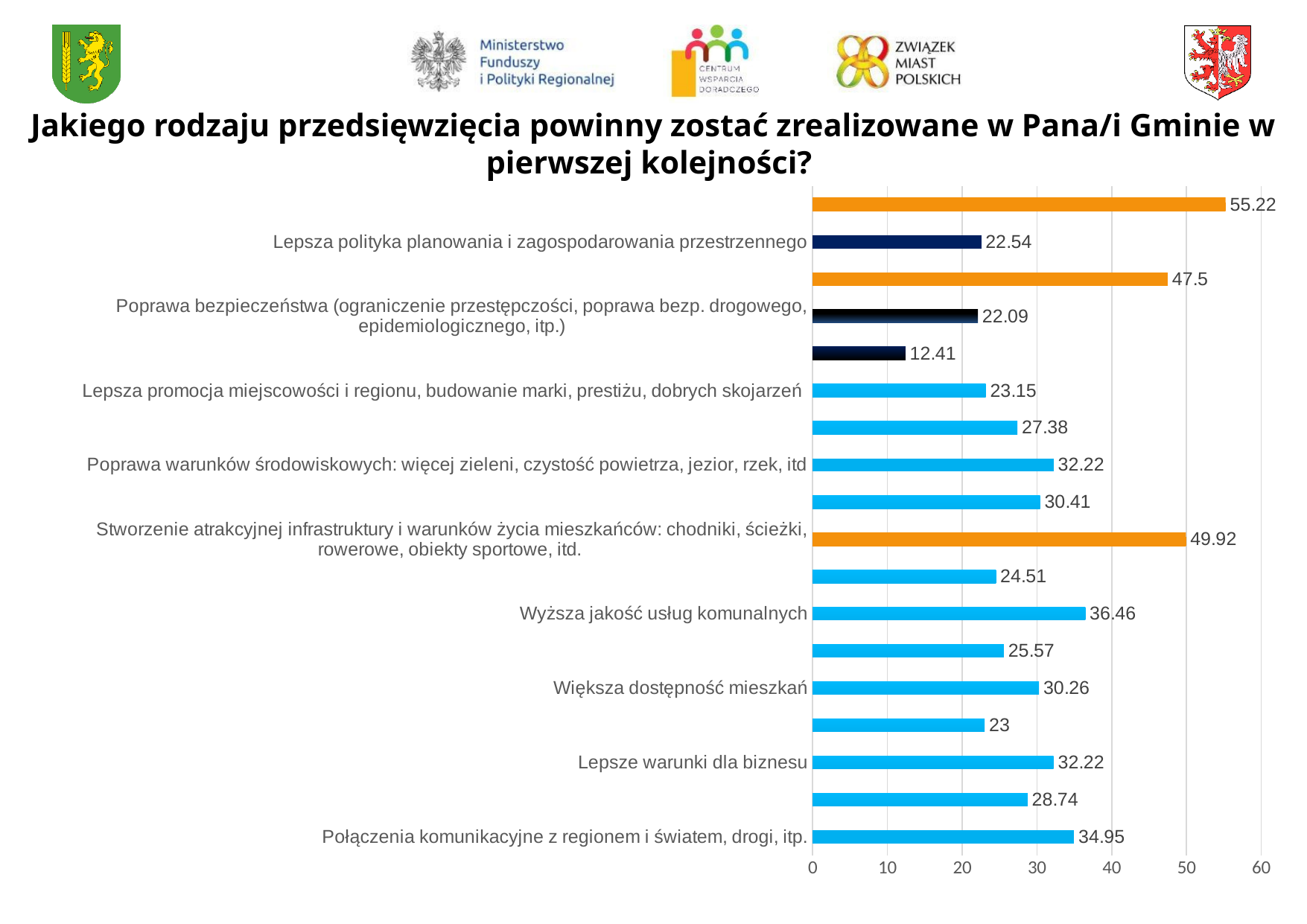
What is the value for "Stworzenie atrakcyjnej infrastruktury i warunków życia mieszkańców: chodniki, ścieżki, rowerowe, obiekty sportowe, itd."? 49.92 What is the value for "Lepsza polityka planowania i zagospodarowania przestrzennego"? 22.54 Among the labelled categories, which has the highest value? Stworzenie atrakcyjnej infrastruktury i warunków życia mieszkańców: chodniki, ścieżki, rowerowe, obiekty sportowe, itd. What is the value for "Połączenia komunikacyjne z regionem i światem, drogi, itp."? 34.95 Which is larger: the value for "Wyższa jakość usług komunalnych" or for "Połączenia komunikacyjne z regionem i światem, drogi, itp."? Wyższa jakość usług komunalnych Is the value for "Lepsza promocja miejscowości i regionu, budowanie marki, prestiżu, dobrych skojarzeń" greater or less than 30? less What is the difference between the values for "Stworzenie atrakcyjnej infrastruktury..." (49.92) and "Wyższa jakość usług komunalnych" (36.46)? 13.46 What is the value for "Większa dostępność mieszkań"? 30.26 How many bars are plotted in the chart? 18 What is the value for "Wyższa jakość usług komunalnych"? 36.46 Among the labelled categories, which has the lowest value? Poprawa bezpieczeństwa (ograniczenie przestępczości, poprawa bezp. drogowego, epidemiologicznego, itp.) What kind of chart is shown on the slide? bar chart